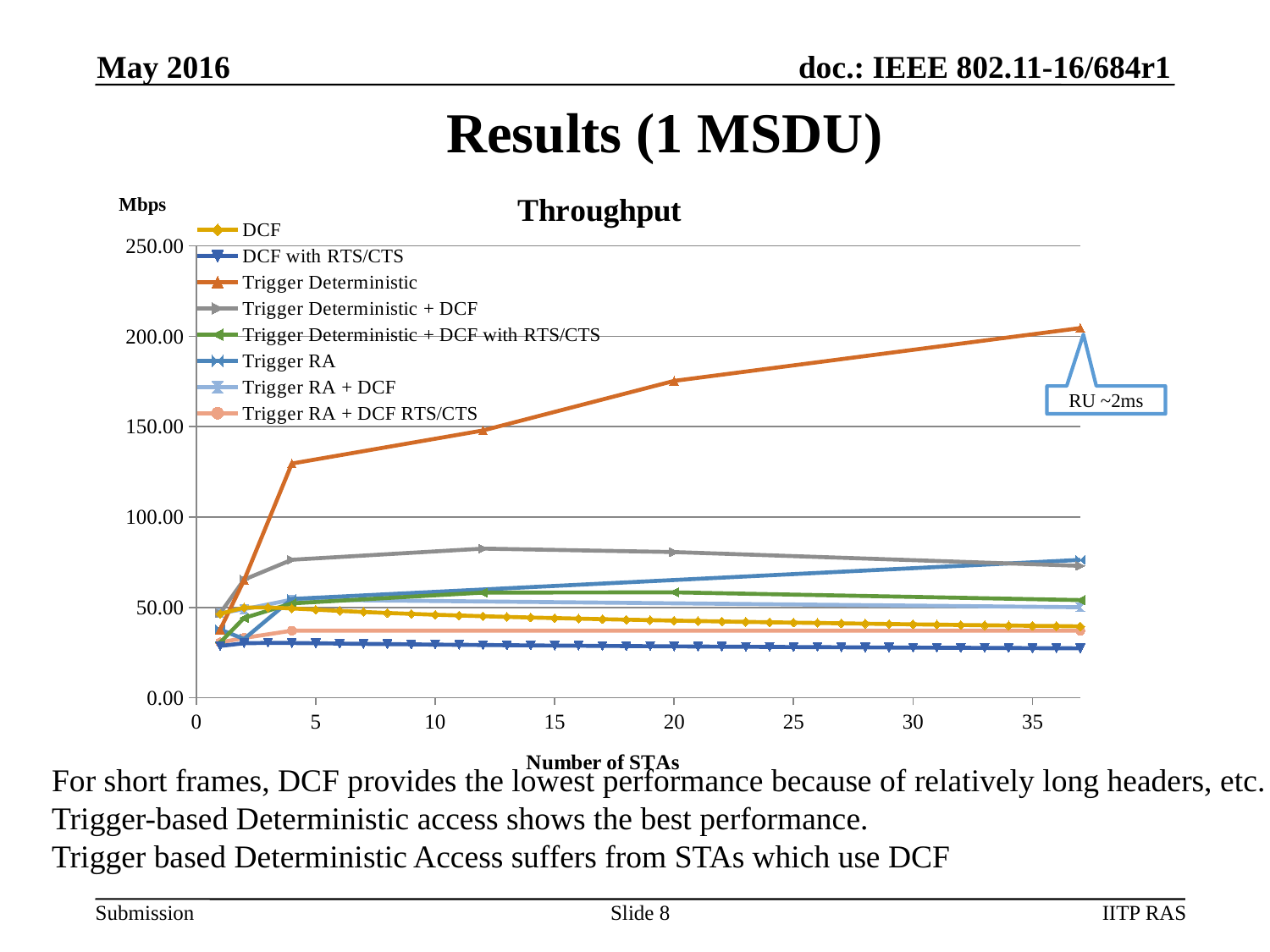
Which series has the lowest throughput at the largest number of STAs? DCF with RTS/CTS Does the throughput of DCF fall or rise as the number of STAs increases beyond 5? falls At 20 STAs, which series has the higher throughput: Trigger Deterministic or Trigger RA? Trigger Deterministic Which series has the highest throughput at the largest number of STAs? Trigger Deterministic What is the title of the chart? Throughput How many series does the legend of the Throughput chart list? 8 Is the throughput of Trigger Deterministic at the largest number of STAs greater or less than 200? greater Does the throughput of Trigger Deterministic rise or fall as the number of STAs increases? rises What is the label of the x axis of the chart? Number of STAs What kind of chart is shown on the slide? line chart Is the throughput of Trigger Deterministic + DCF at 10 STAs greater or less than 100? less Is the throughput of DCF with RTS/CTS at 35 STAs greater or less than 50? less